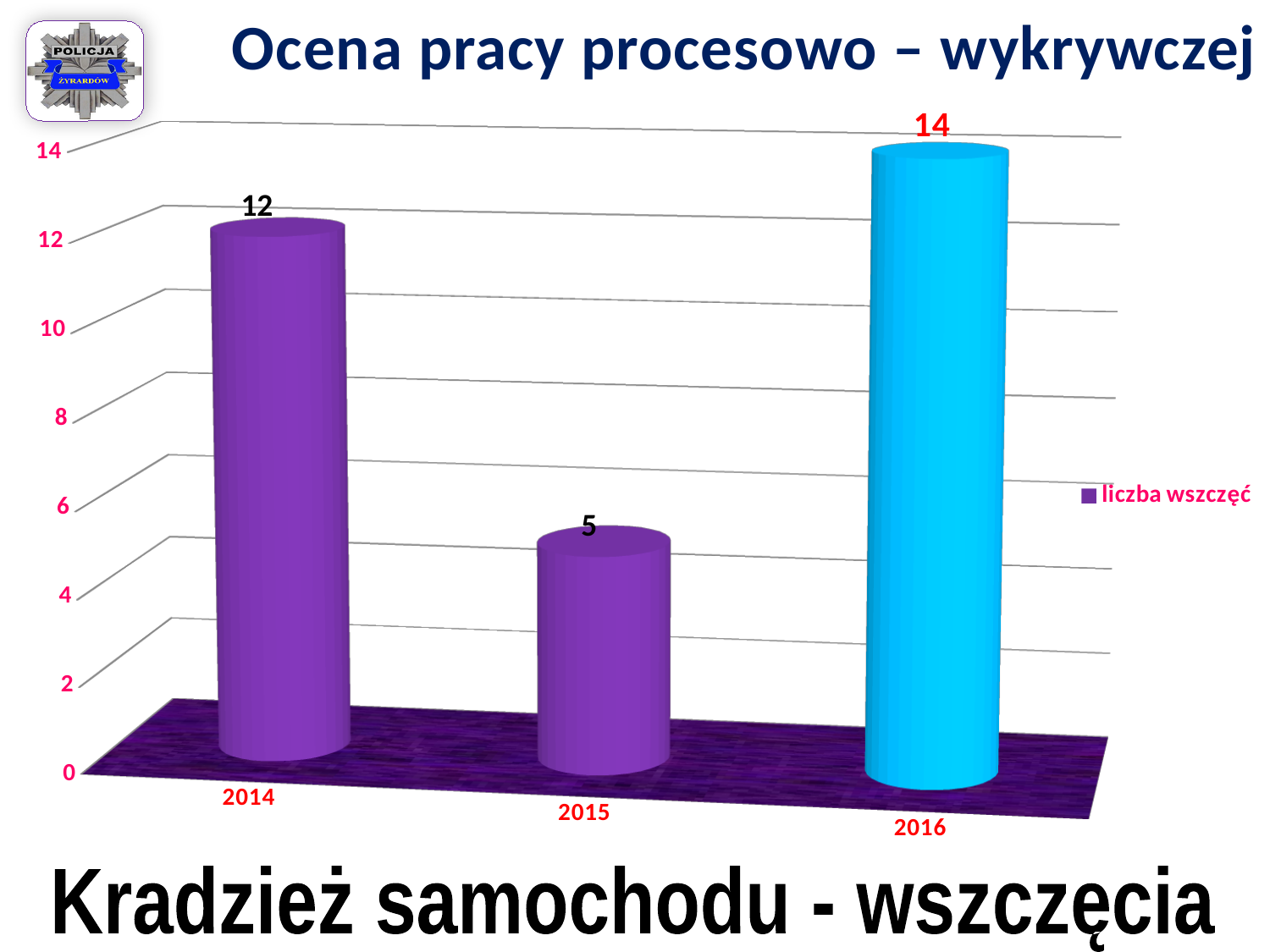
What is the value for 2014? 12 What is the value for 2015? 5 What is the difference between the values for 2014 and 2015? 7 What is the value for 2016? 14 What kind of chart is shown? bar chart How many series does the legend list? 1 How many years are shown on the x axis? 3 Which is larger, the value for 2014 or the value for 2016? 2016 What is the difference between the values for 2016 and 2015? 9 Which year has the highest value? 2016 What is the legend entry for the series? liczba wszczęć Which year has the lowest value? 2015